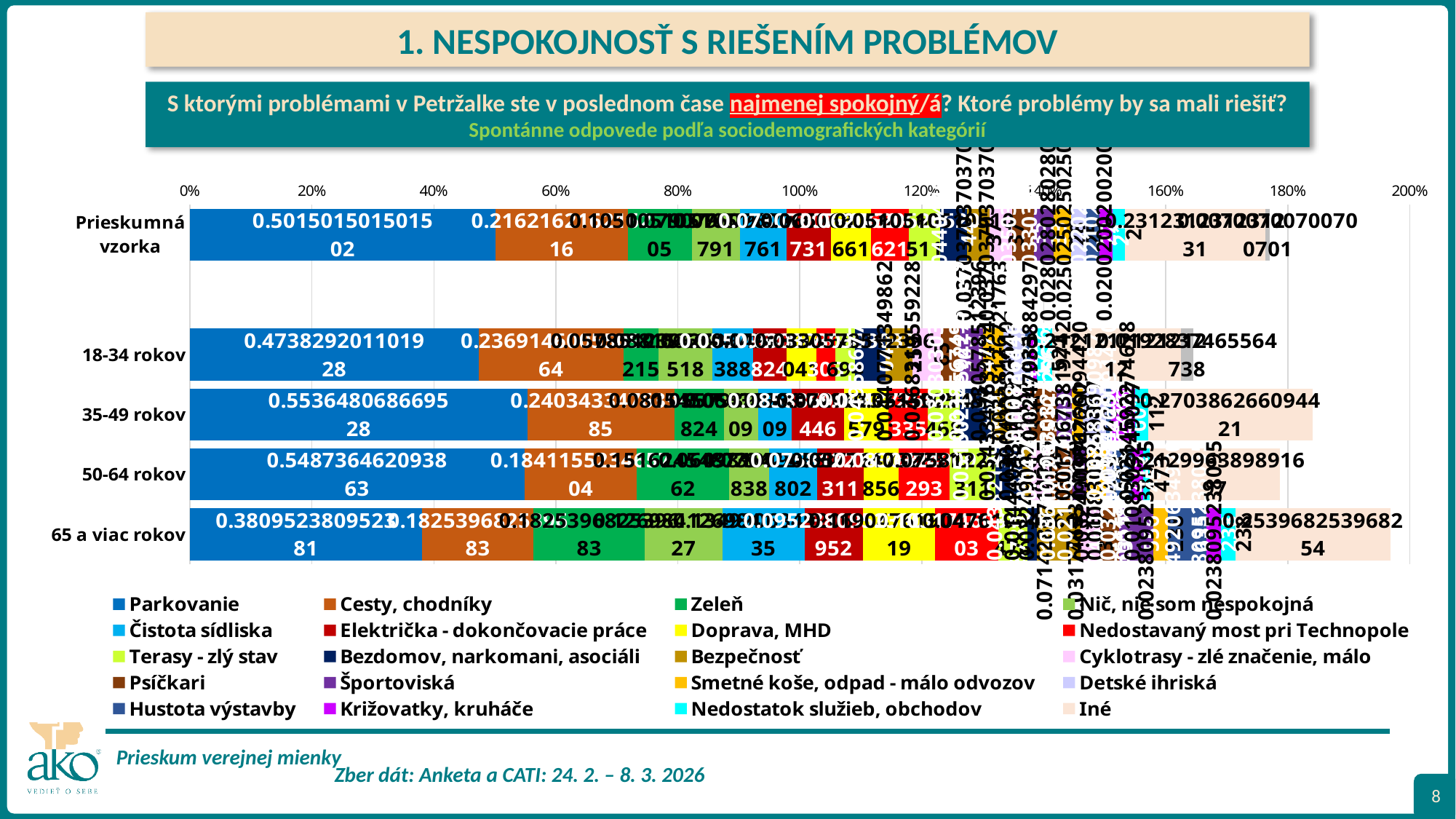
Which colour represents Parkovanie in the legend? Blue What is the value of Iné for 65 a viac rokov? 0.253968253968254 How many sociodemographic categories (rows) are plotted in the chart? 5 How many series does the legend list? 20 Which category has the lowest value for Parkovanie? 65 a viac rokov What is the value of Cesty, chodníky for 18-34 rokov? 0.236914600550964 Which category has the highest value for Parkovanie? 35-49 rokov What kind of chart is shown on the slide? Stacked bar chart What is the value of Cesty, chodníky for Prieskumná vzorka? 0.216216216216216 What is the value of Parkovanie for Prieskumná vzorka? 0.501501501501502 Which has the larger value for Cesty, chodníky: 35-49 rokov or 50-64 rokov? 35-49 rokov What is the value of Parkovanie for 65 a viac rokov? 0.380952380952381